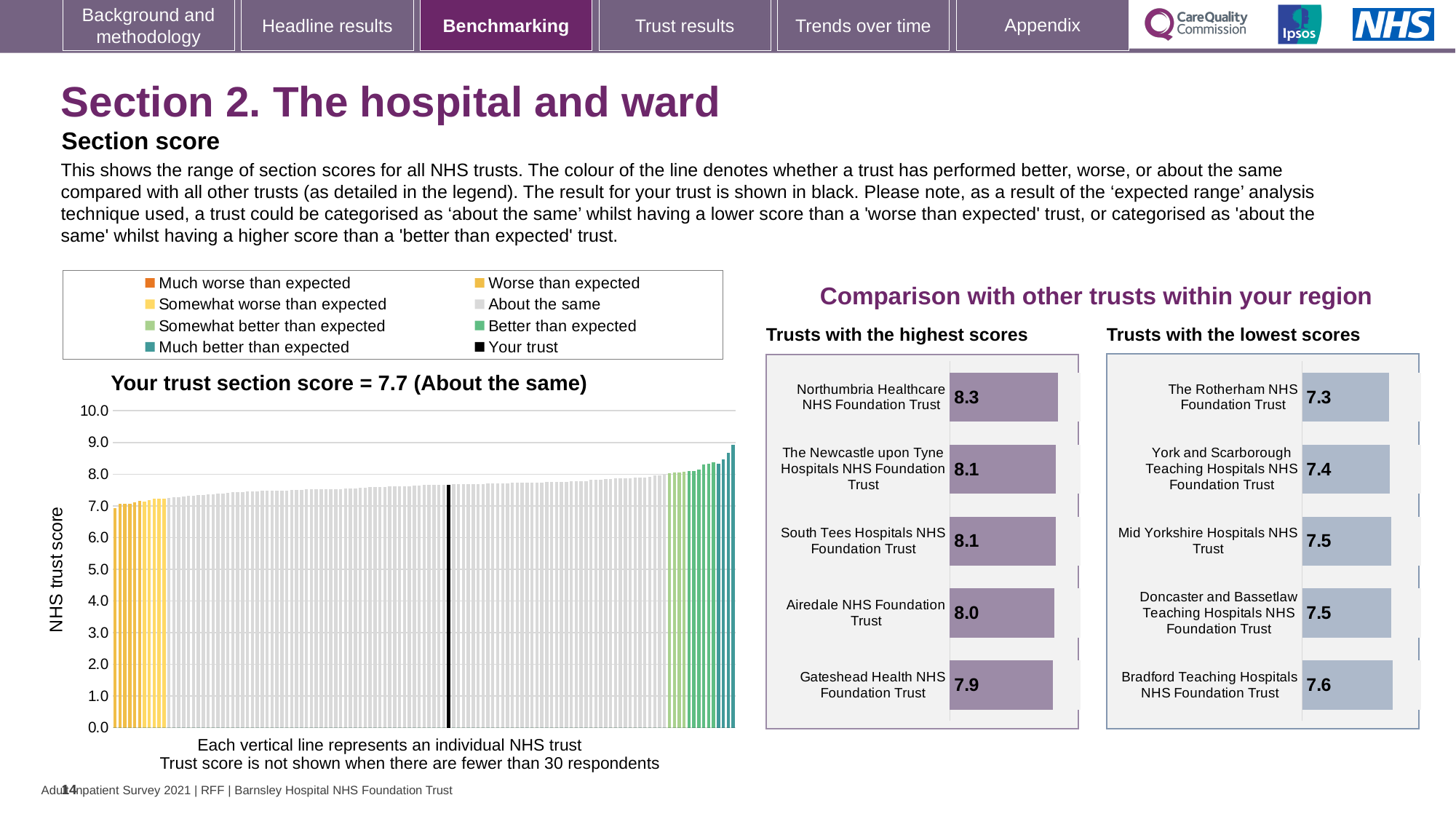
In the 'Trusts with the lowest scores' chart, which trust has the lowest score? The Rotherham NHS Foundation Trust In the 'Trusts with the highest scores' chart, which trust has the highest score? Northumbria Healthcare NHS Foundation Trust In the 'Trusts with the highest scores' chart, what is the score for Gateshead Health NHS Foundation Trust? 7.9 In the 'Trusts with the lowest scores' chart, what is the score for Bradford Teaching Hospitals NHS Foundation Trust? 7.6 What is the difference between the score for Northumbria Healthcare NHS Foundation Trust in the highest scores chart and the score for The Rotherham NHS Foundation Trust in the lowest scores chart? 1.0 In the 'Trusts with the highest scores' chart, what is the score for Northumbria Healthcare NHS Foundation Trust? 8.3 In the 'Trusts with the lowest scores' chart, what is the score for The Rotherham NHS Foundation Trust? 7.3 In the main chart on the left showing all NHS trusts, do the trust scores rise or fall from left to right? rise In the 'Trusts with the highest scores' chart, how many trusts are shown? 5 How many entries does the legend above the main chart on the left list? 8 In the main chart on the left showing all NHS trusts, what is your trust's section score? 7.7 In the 'Trusts with the lowest scores' chart, which is larger: the score for Mid Yorkshire Hospitals NHS Trust or the score for York and Scarborough Teaching Hospitals NHS Foundation Trust? Mid Yorkshire Hospitals NHS Trust